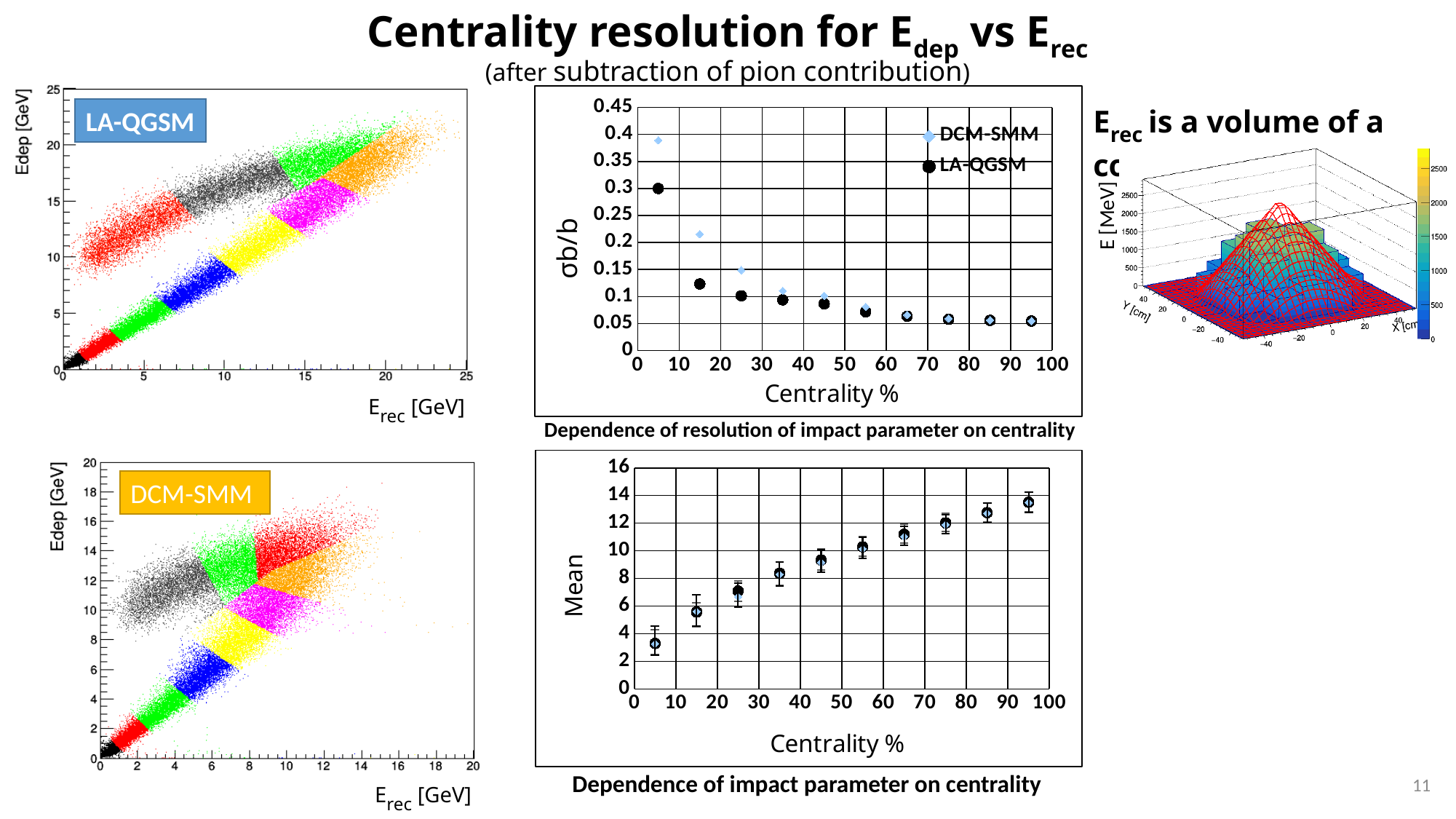
What kind of chart is the LA-QGSM plot at the top left of the slide? scatter plot In the chart titled 'Dependence of resolution of impact parameter on centrality', do the σb/b values rise or fall as centrality increases? fall What is the y-axis label of the chart titled 'Dependence of impact parameter on centrality'? Mean In the chart titled 'Dependence of resolution of impact parameter on centrality', is the DCM-SMM value at 5% centrality greater or less than 0.35? greater In the chart titled 'Dependence of resolution of impact parameter on centrality', at which centrality value is the LA-QGSM σb/b highest? 5 In the chart titled 'Dependence of resolution of impact parameter on centrality', how many series does the legend list? 2 In the chart titled 'Dependence of impact parameter on centrality', is the Mean value at 95% centrality greater or less than 12? greater In the chart titled 'Dependence of resolution of impact parameter on centrality', how many data points are plotted for the LA-QGSM series? 10 In the chart titled 'Dependence of resolution of impact parameter on centrality', at 5% centrality, which series has the larger σb/b value, DCM-SMM or LA-QGSM? DCM-SMM In the chart titled 'Dependence of impact parameter on centrality', at which centrality value is the Mean lowest? 5 In the chart titled 'Dependence of impact parameter on centrality', is the Mean value at 5% centrality greater or less than 4? less In the chart titled 'Dependence of impact parameter on centrality', do the Mean values rise or fall as centrality increases? rise